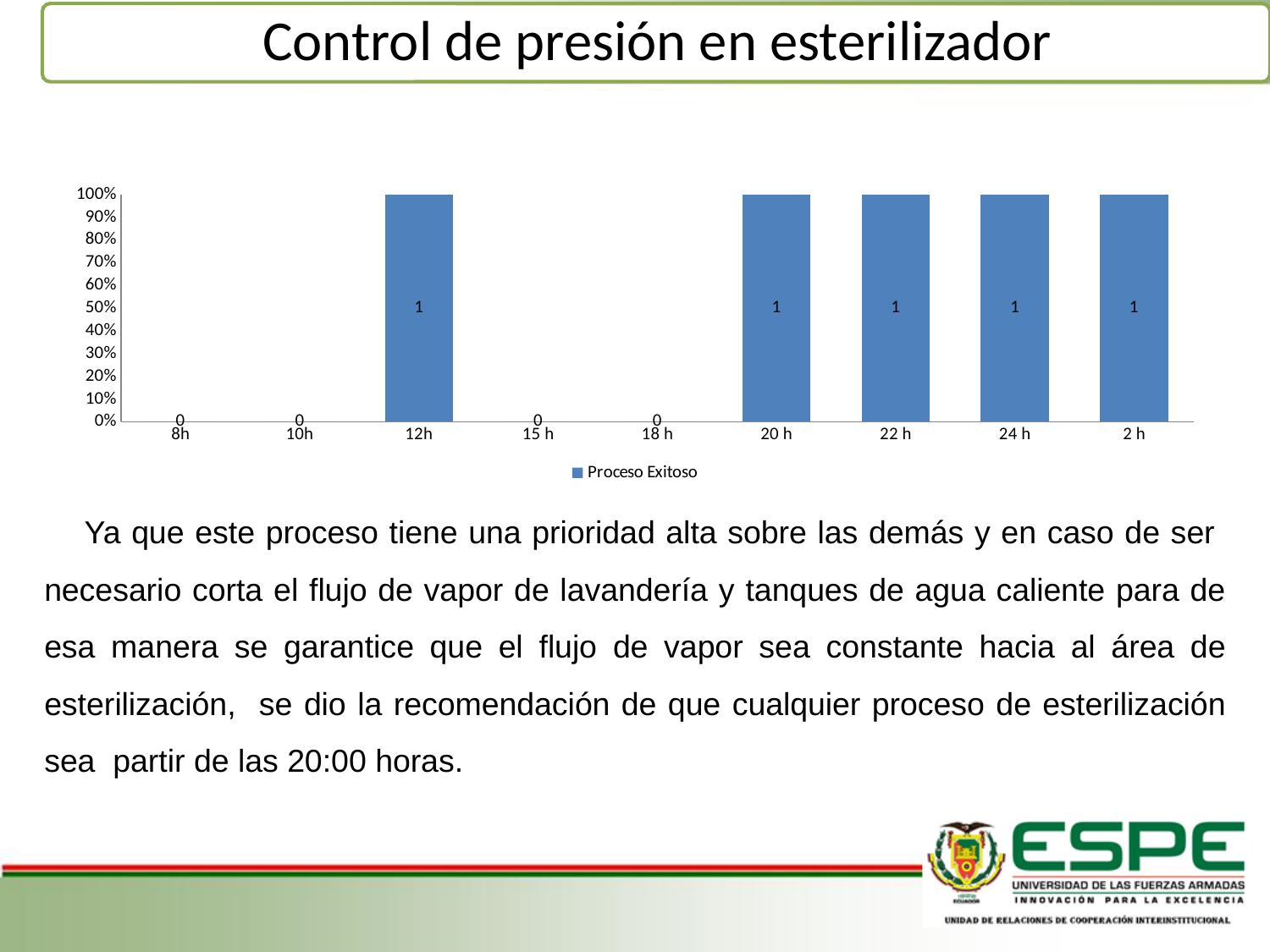
What is the data label shown for 8h? 0 Is the value for 20 h greater or less than 50%? greater What is the data label shown for 18 h? 0 How many categories are shown on the x axis? 9 Which is larger, the value for 12h or the value for 10h? 12h What is the data label on the bar for 2 h? 1 What is the title of the slide containing the chart? Control de presión en esterilizador What is the data label on the bar for 12h? 1 What is the name of the series in the legend? Proceso Exitoso Is the value for 15 h greater or less than 50%? less What kind of chart is shown on the slide? bar chart How many series does the legend list? 1